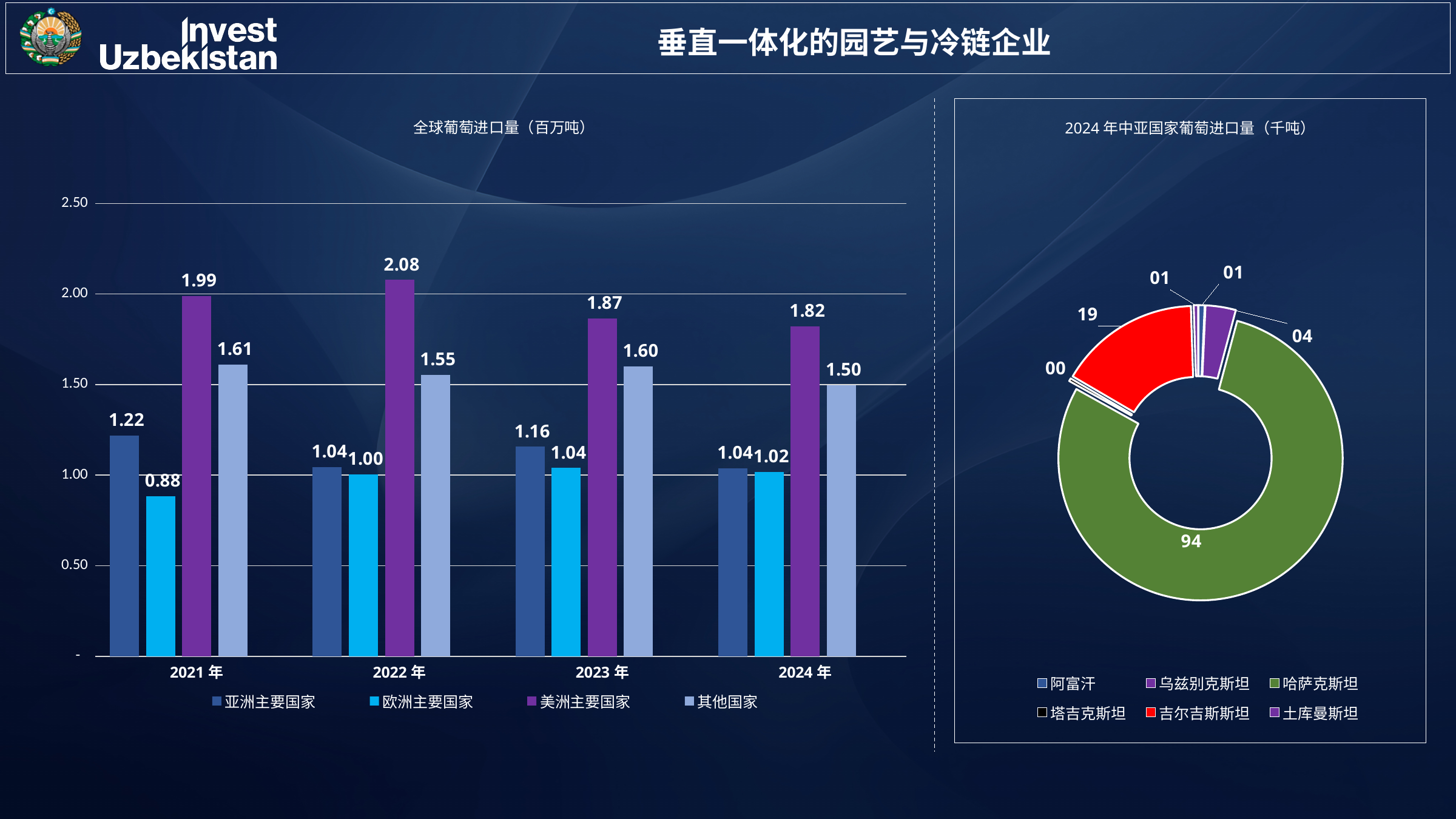
In the chart titled 全球葡萄进口量（百万吨）, does the value for 美洲主要国家 rise or fall from 2022 年 to 2024 年? fall In the chart titled 全球葡萄进口量（百万吨）, what is the difference between 美洲主要国家 and 亚洲主要国家 in 2023 年? 0.71 In the chart titled 全球葡萄进口量（百万吨）, how many series does the legend list? 4 In the chart titled 全球葡萄进口量（百万吨）, what is the value for 其他国家 in 2024 年? 1.50 In the chart titled 2024 年中亚国家葡萄进口量（千吨）, how many countries does the legend list? 6 In the chart titled 全球葡萄进口量（百万吨）, which series has the lowest value in 2021 年? 欧洲主要国家 In the chart titled 2024 年中亚国家葡萄进口量（千吨）, which country has the largest slice? 哈萨克斯坦 In the chart titled 全球葡萄进口量（百万吨）, which year has the highest value for 美洲主要国家? 2022 年 What kind of chart is the one titled 全球葡萄进口量（百万吨）? bar chart In the chart titled 全球葡萄进口量（百万吨）, which is larger in 2024 年: 亚洲主要国家 or 欧洲主要国家? 亚洲主要国家 In the chart titled 全球葡萄进口量（百万吨）, what is the value for 欧洲主要国家 in 2021 年? 0.88 In the chart titled 全球葡萄进口量（百万吨）, what is the value for 美洲主要国家 in 2022 年? 2.08